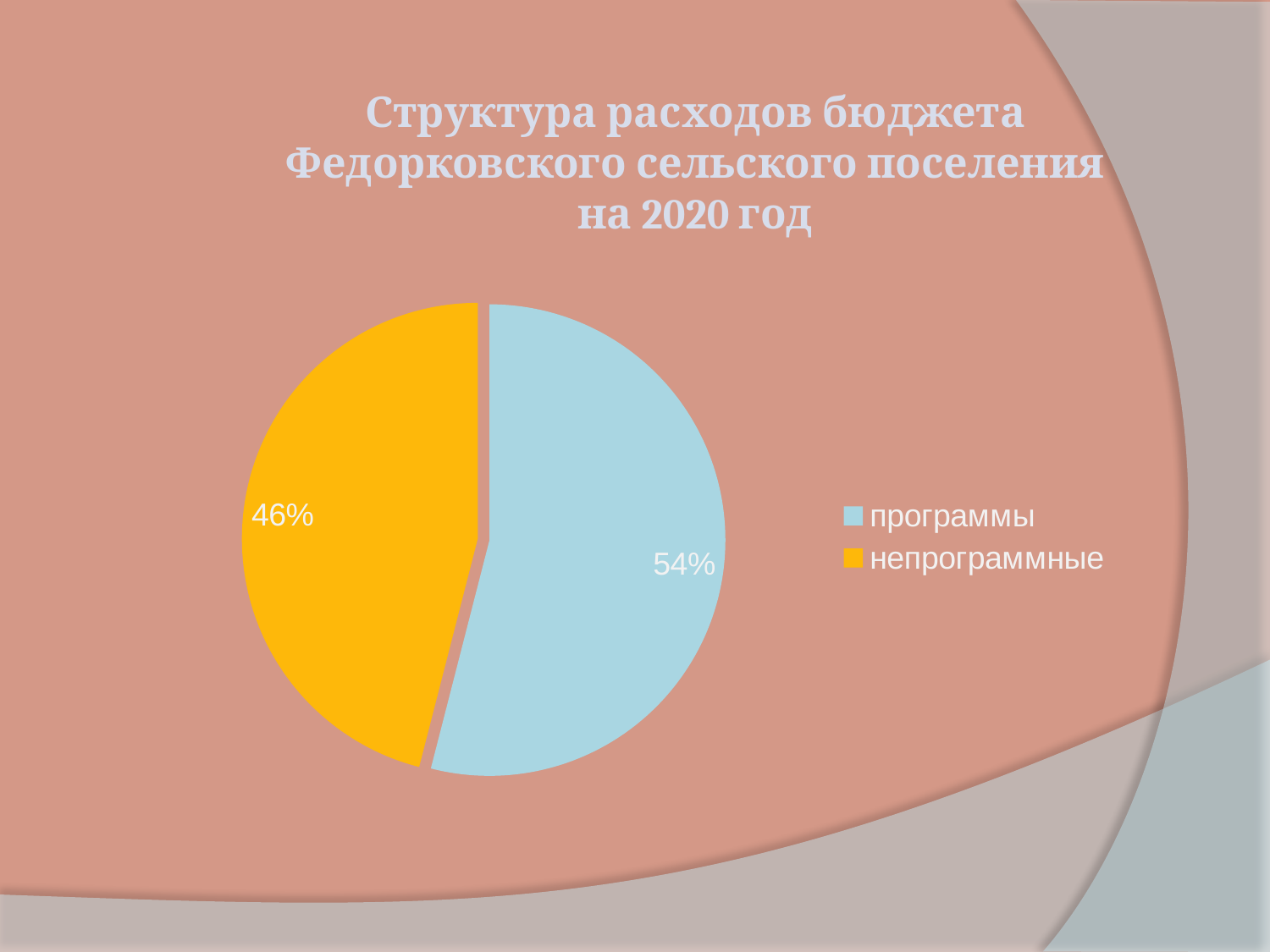
What share of the pie does "программы" take? 54% Which slice is the smallest? непрограммные What colour is the "непрограммные" slice? orange What is the title of the chart? Структура расходов бюджета Федорковского сельского поселения на 2020 год How many entries does the legend list? 2 Which slice is the largest? программы What is the difference in percentage points between "программы" and "непрограммные"? 8 How many slices does the pie chart have? 2 What share of the pie does "непрограммные" take? 46% Which is larger, "программы" or "непрограммные"? программы What kind of chart is shown on the slide? pie chart